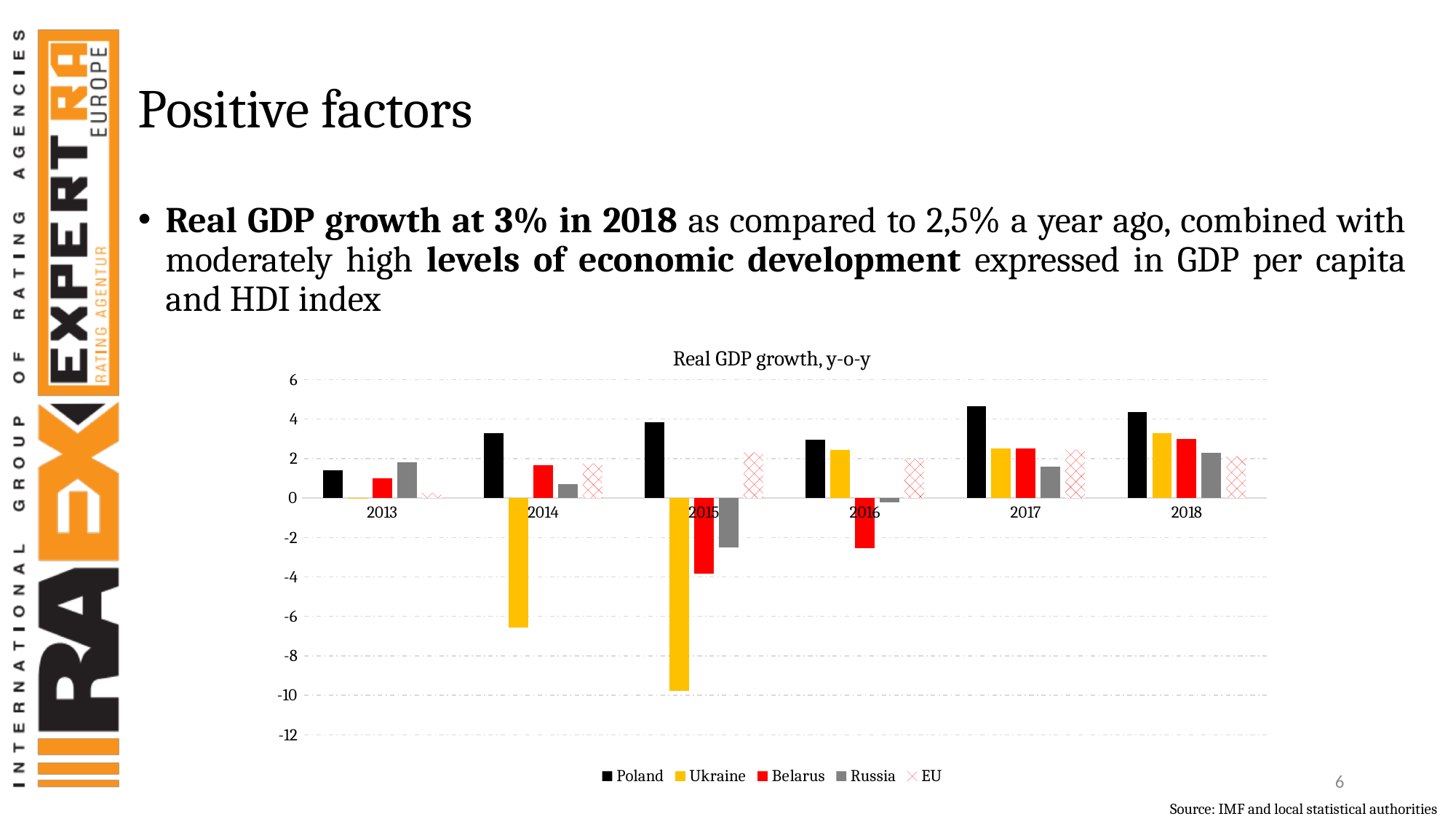
How many years are shown on the x axis of the chart? 6 Which country has the lowest real GDP growth in 2016? Belarus Which country and year has the highest real GDP growth in the chart? Poland in 2017 What is the title of the chart? Real GDP growth, y-o-y Is the value for Poland in 2017 greater or less than 4? greater Is the value for Ukraine in 2014 greater or less than -4? less In 2018, which is larger: the value for Poland or the value for Ukraine? Poland What type of chart is shown on the slide? Bar chart Which country and year has the lowest real GDP growth in the chart? Ukraine in 2015 How many series does the legend of the chart list? 5 Is the value for Ukraine in 2015 greater or less than -8? less In 2015, which is lower: the value for Belarus or the value for Russia? Belarus